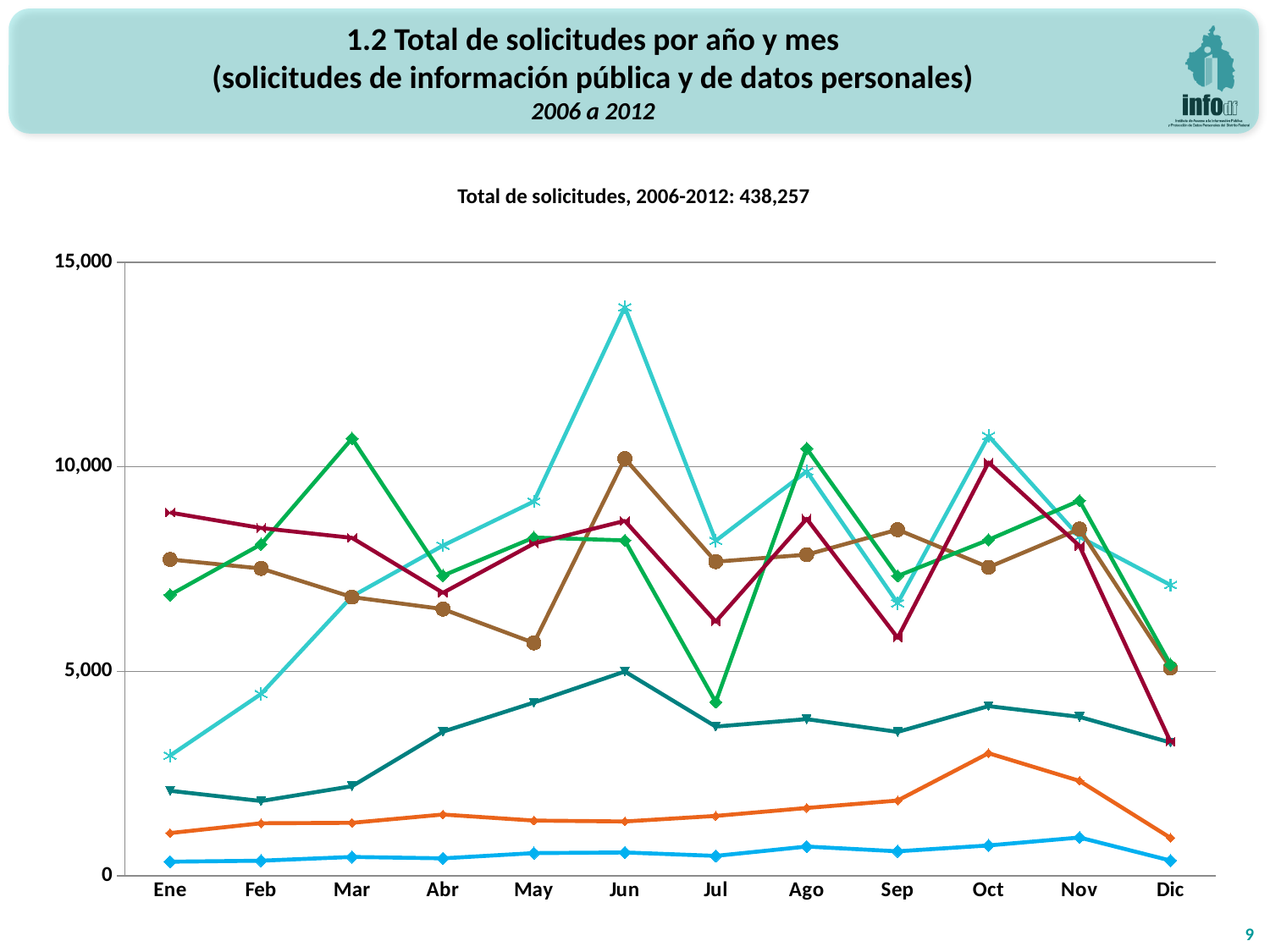
In which month does the light cyan line reach its highest value? Jun Does the orange line rise or fall from Oct to Dic? fall What total number of solicitudes for 2006-2012 is printed above the chart? 438,257 How many months are shown along the x axis of the chart? 12 Is the value of the dark teal line in Ene greater or less than 5,000? less In Jun, which line has the larger value: the light cyan line or the brown line? the light cyan line Is the value of the dark red line in Dic greater or less than 5,000? less Is the value of the green line in Mar greater or less than 10,000? greater What kind of chart is shown on the slide? line chart In which month does the brown line reach its lowest value? Dic In which month does the orange line reach its highest value? Oct